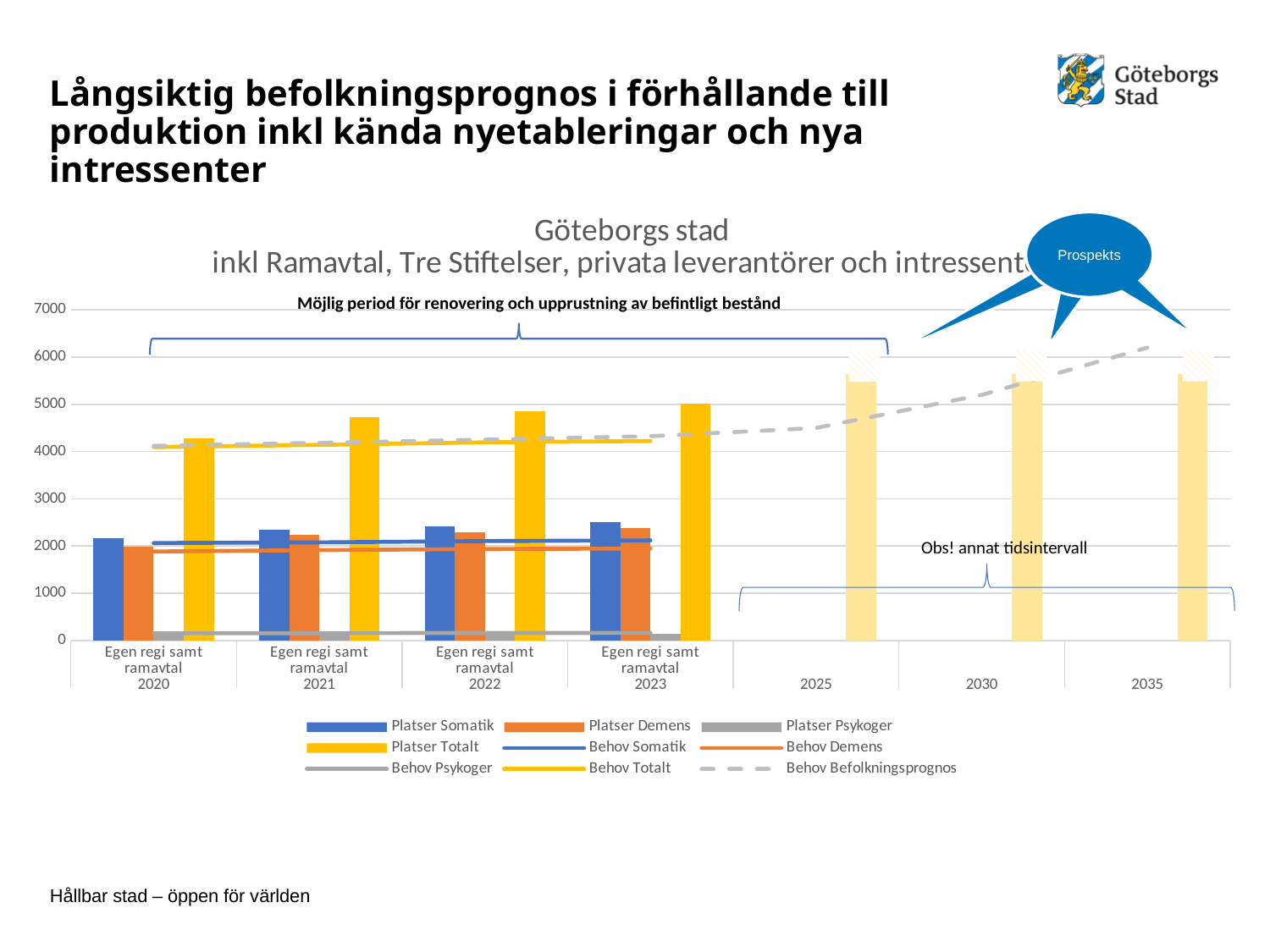
Which legend series is drawn as a dashed grey line? Behov Befolkningsprognos What kind of chart is shown on the slide? bar chart (with line series) How many series does the chart legend list? 9 Is the value for Platser Totalt in 2020 greater or less than 4000? greater Is the value for Platser Somatik in 2020 greater or less than 2000? greater How many year categories are shown along the x axis? 7 Is the value for Platser Totalt in 2021 greater or less than 5000? less Among the years 2020 to 2023, which year has the lowest Platser Totalt bar? 2020 Does the dashed Behov Befolkningsprognos line rise or fall from 2020 to 2035? rise Which is larger in 2020, Platser Somatik or Platser Demens? Platser Somatik